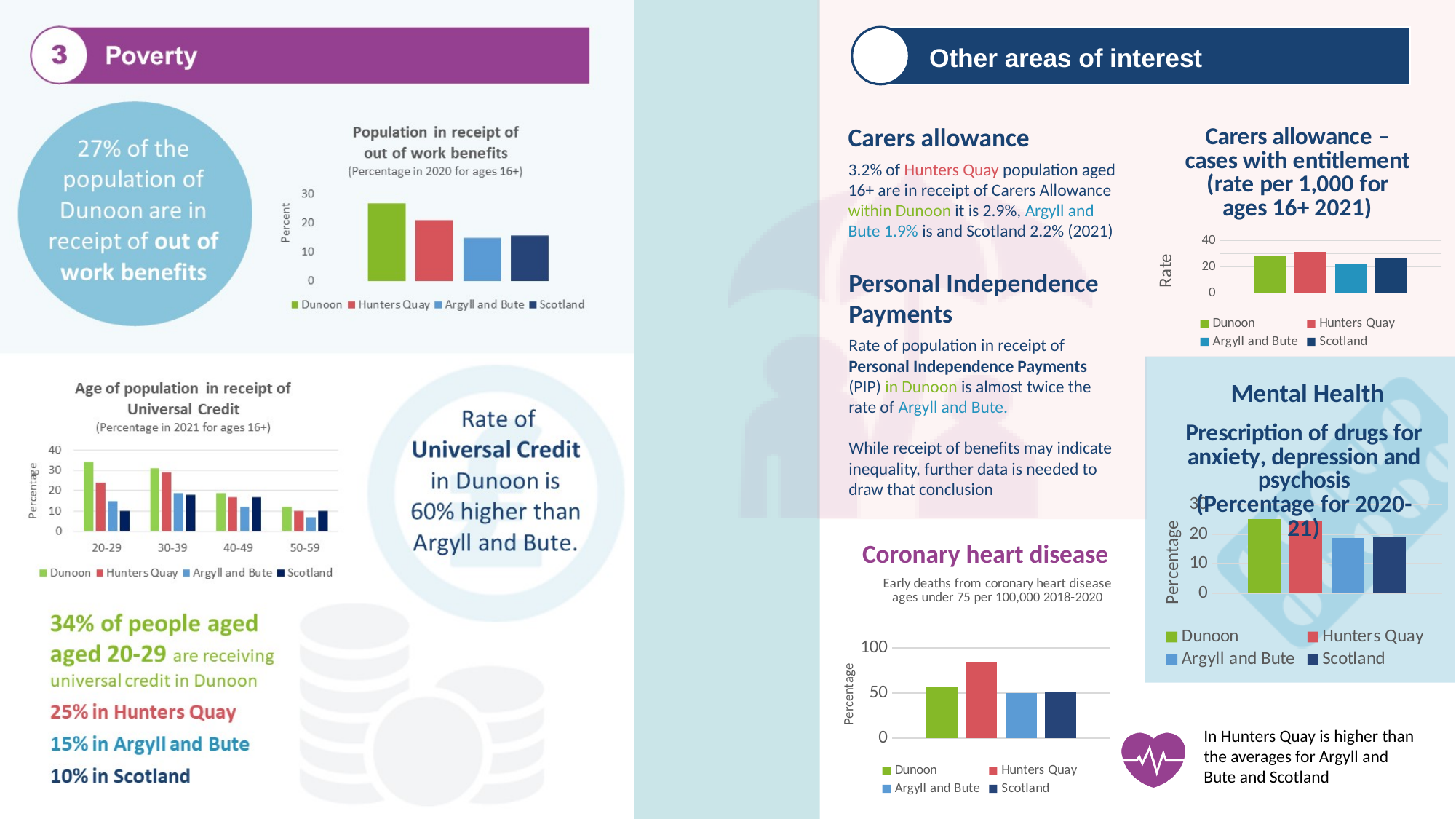
In the 'Age of population in receipt of Universal Credit' chart, what is the difference between Dunoon and Scotland in the 20-29 age group? 24 percentage points How many series does the legend of the 'Age of population in receipt of Universal Credit' chart list? 4 In the 'Coronary heart disease' chart, is the value for Hunters Quay greater or less than 50? greater In the 'Coronary heart disease' chart, which is larger, the value for Hunters Quay or the value for Dunoon? Hunters Quay In the 'Age of population in receipt of Universal Credit' chart, what is the value for Dunoon in the 20-29 age group? 34% In the 'Population in receipt of out of work benefits' chart, which area has the highest value? Dunoon In the 'Population in receipt of out of work benefits' chart, what is the value for Dunoon? 27% In the 'Carers allowance – cases with entitlement' chart, which area has the highest rate? Hunters Quay In the 'Age of population in receipt of Universal Credit' chart, do the Dunoon values rise or fall as the age groups increase? fall In the 'Population in receipt of out of work benefits' chart, is the value for Argyll and Bute greater or less than 20? less In the 'Carers allowance – cases with entitlement' chart, which area has the lowest rate? Argyll and Bute What kind of chart is the 'Prescription of drugs for anxiety, depression and psychosis' chart under Mental Health? bar chart